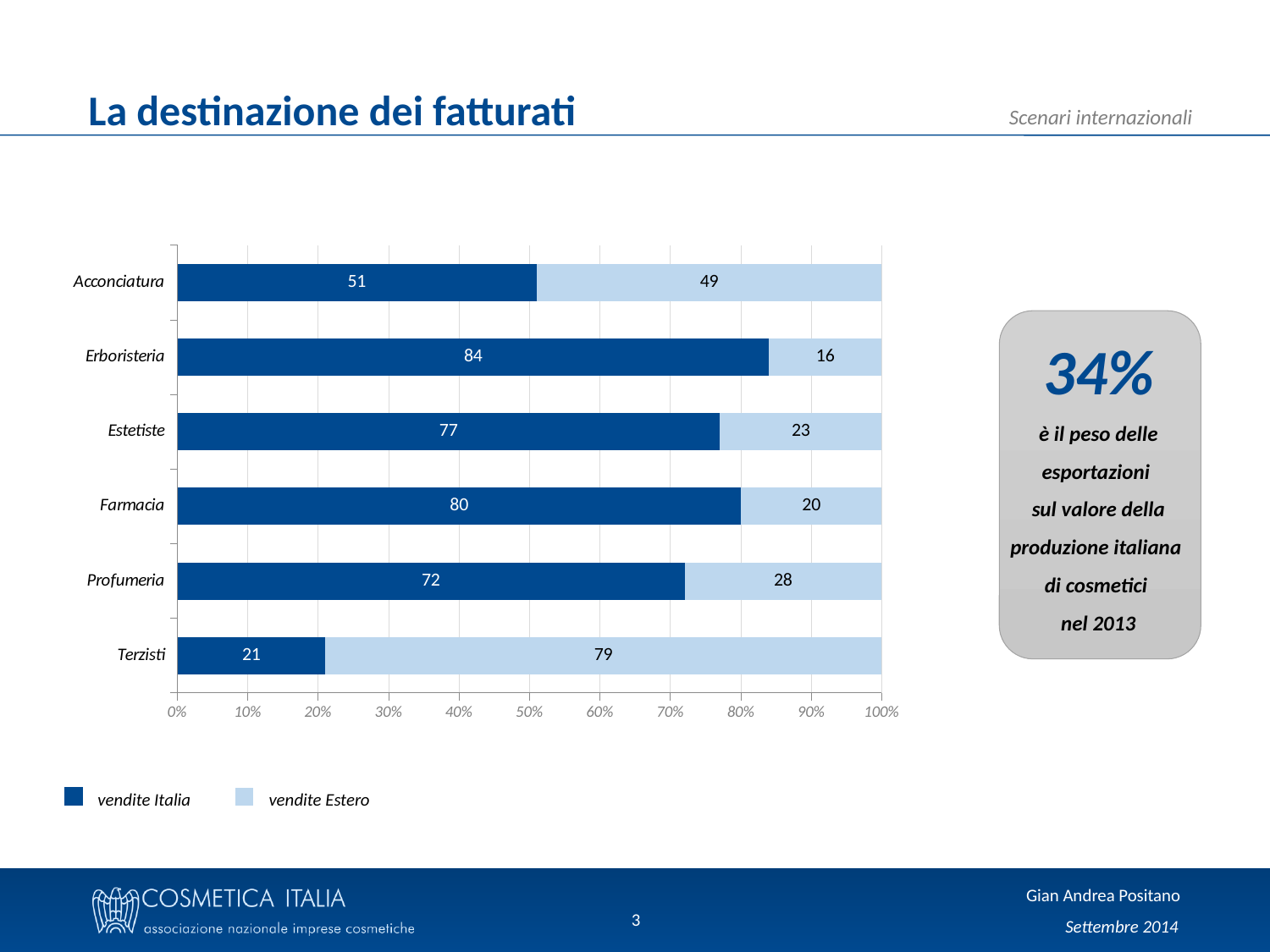
What kind of chart is shown on the slide? Stacked bar chart What is the vendite Estero value for Acconciatura? 49 What is the vendite Estero value for Terzisti? 79 Which category has the highest vendite Italia value? Erboristeria How many categories are shown on the chart? 6 What are the two series named in the legend? vendite Italia and vendite Estero What is the vendite Italia value for Erboristeria? 84 What is the difference between the vendite Italia values for Farmacia and Profumeria? 8 How many series does the legend list? 2 Which is larger, the vendite Estero value for Estetiste or for Farmacia? Estetiste Which category has the lowest vendite Italia value? Terzisti What is the total of the stacked bar for Profumeria? 100